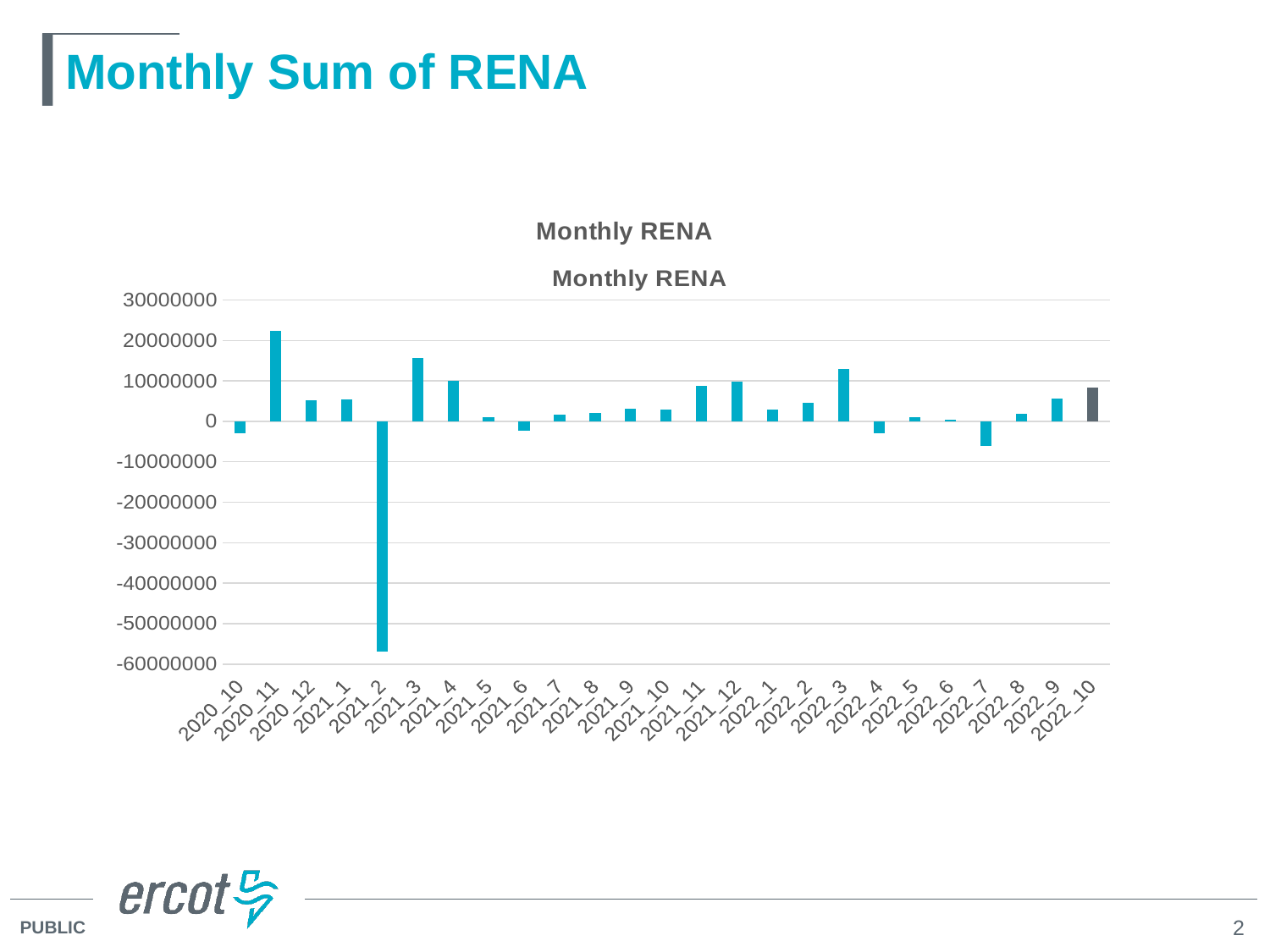
Which month has the lowest value? 2021_2 Is the value for 2022_3 greater or less than 10000000? greater What is the title of the chart? Monthly RENA What kind of chart is shown on the slide? bar chart Which month's bar is drawn in a different colour (dark grey) from the rest? 2022_10 Is the value for 2022_7 greater or less than 0? less Is the value for 2021_2 greater or less than -50000000? less Which is larger, the value for 2022_3 or the value for 2022_2? 2022_3 How many monthly categories are plotted on the x axis? 25 Which is larger, the value for 2020_11 or the value for 2021_3? 2020_11 Which month has the highest value? 2020_11